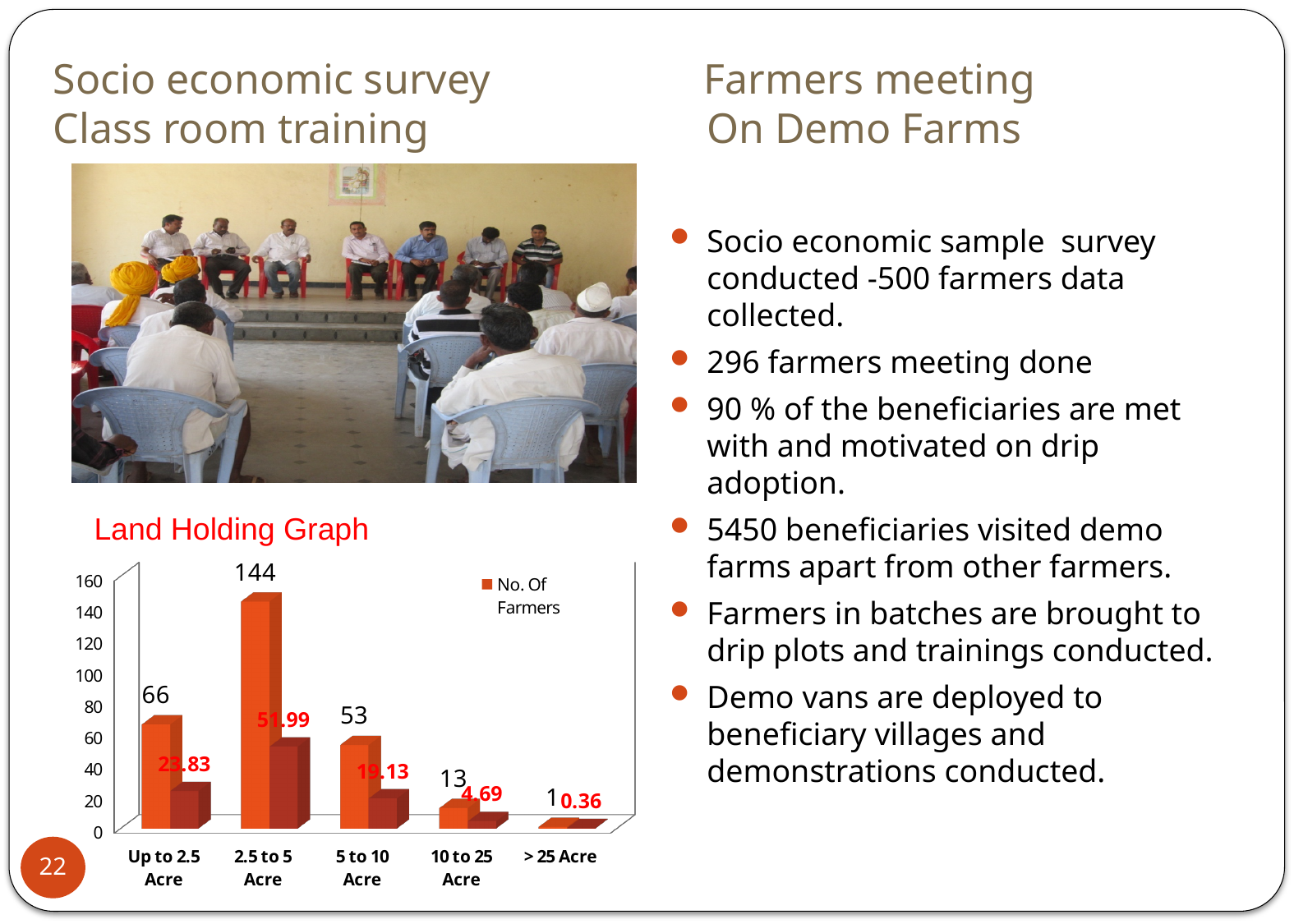
In the Land Holding Graph, what value is printed in red next to the 2.5 to 5 Acre bars? 51.99 In the Land Holding Graph, what is the No. Of Farmers for the 10 to 25 Acre category? 13 In the Land Holding Graph, how many more farmers are in the 2.5 to 5 Acre category than in the Up to 2.5 Acre category? 78 In the Land Holding Graph, what is the No. Of Farmers for the Up to 2.5 Acre category? 66 In the Land Holding Graph, which has more farmers: Up to 2.5 Acre or 5 to 10 Acre? Up to 2.5 Acre What type of chart is the Land Holding Graph? Bar chart In the Land Holding Graph, which land holding category has the lowest No. Of Farmers? > 25 Acre In the Land Holding Graph, what is the difference in No. Of Farmers between the 5 to 10 Acre and 10 to 25 Acre categories? 40 In the Land Holding Graph, what is the No. Of Farmers for the 2.5 to 5 Acre category? 144 In the Land Holding Graph, which land holding category has the highest No. Of Farmers? 2.5 to 5 Acre How many series does the legend of the Land Holding Graph list? 1 How many land holding categories are shown on the x axis of the Land Holding Graph? 5